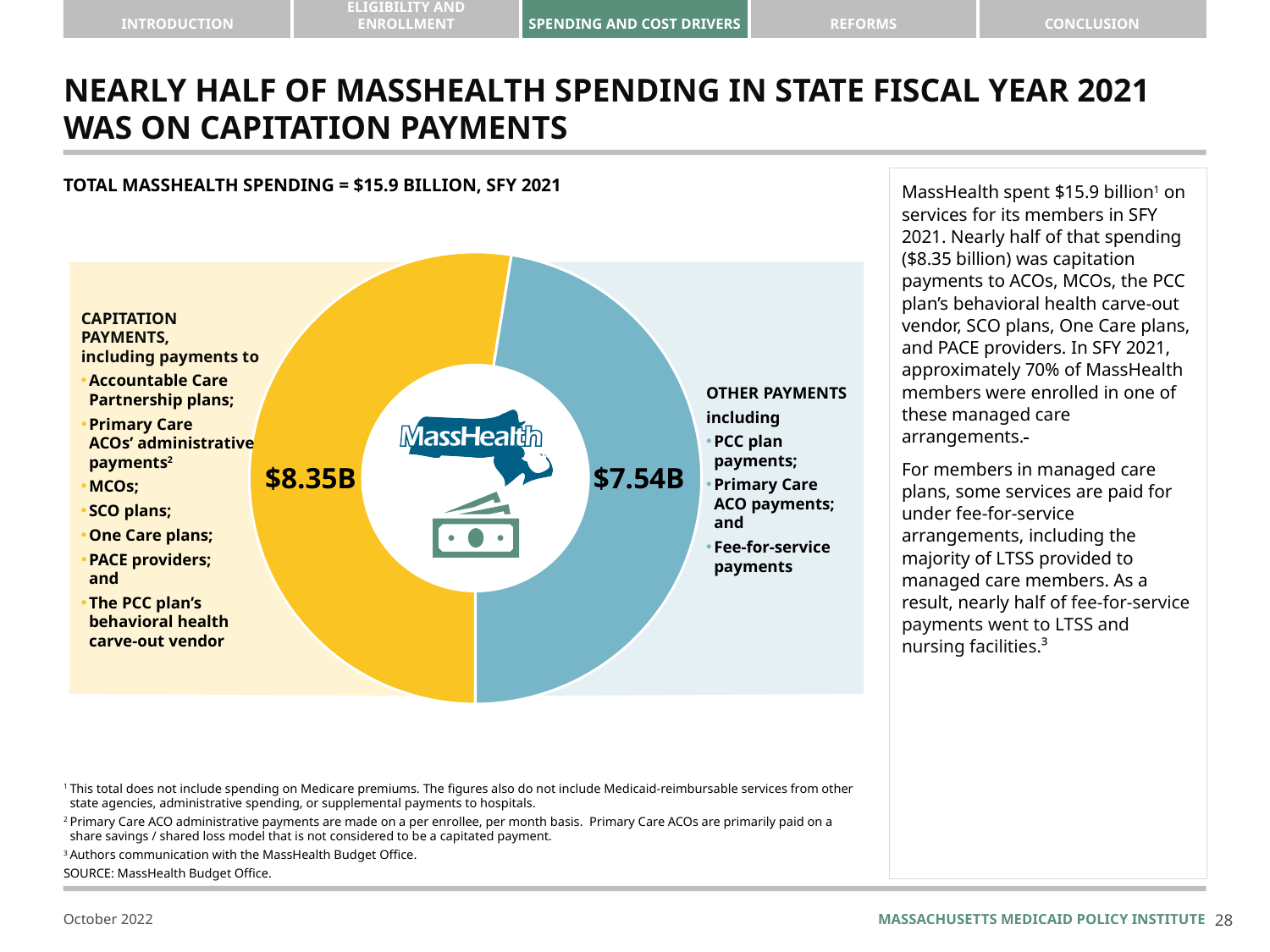
How many slices does the chart have? 2 Which category has the larger value? Capitation Payments What colour is the Capitation Payments slice? Yellow What is the value shown for Other Payments? $7.54B What is the difference between the Capitation Payments value and the Other Payments value? $0.81B Is the value for Capitation Payments larger or smaller than the value for Other Payments? Larger What is the value shown for Capitation Payments? $8.35B What is the title printed above the chart? TOTAL MASSHEALTH SPENDING = $15.9 BILLION, SFY 2021 What kind of chart is shown on the slide? Pie chart (donut) What is the total MassHealth spending shown for SFY 2021? $15.9 billion Which category has the smaller value? Other Payments